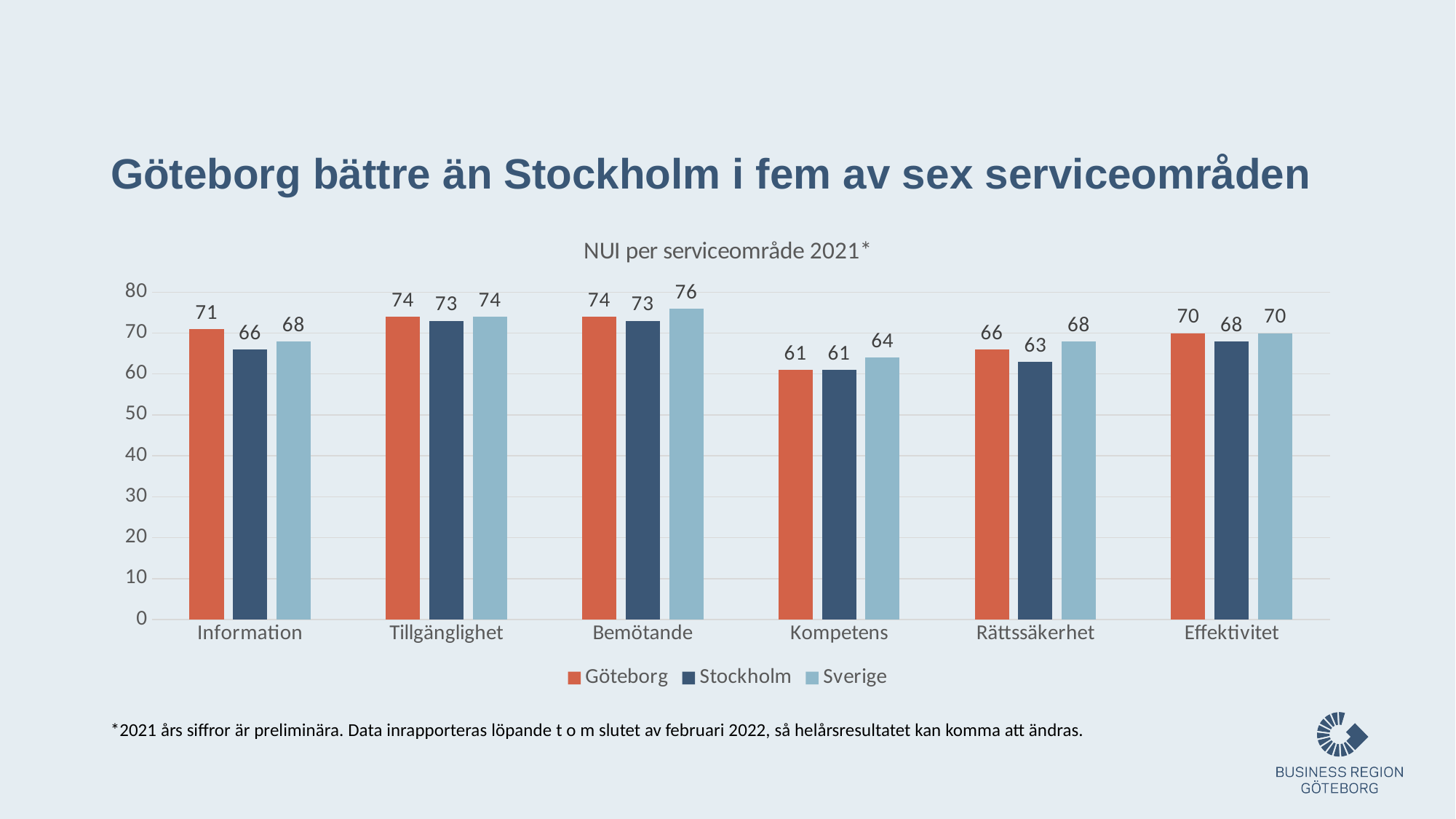
Which is larger for Effektivitet: the Göteborg value or the Stockholm value? Göteborg What is the difference between the Göteborg and Stockholm values for Information? 5 What kind of chart is shown on the slide? Bar chart Which colour represents Göteborg in the chart? Orange-red Which service area has the highest Sverige value? Bemötande How many series does the legend list? 3 What is the Göteborg value for Information? 71 Which service area has the lowest Göteborg value? Kompetens What is the Sverige value for Bemötande? 76 What is the title of the chart? NUI per serviceområde 2021* What is the Stockholm value for Rättssäkerhet? 63 How many service areas are shown on the x axis? 6